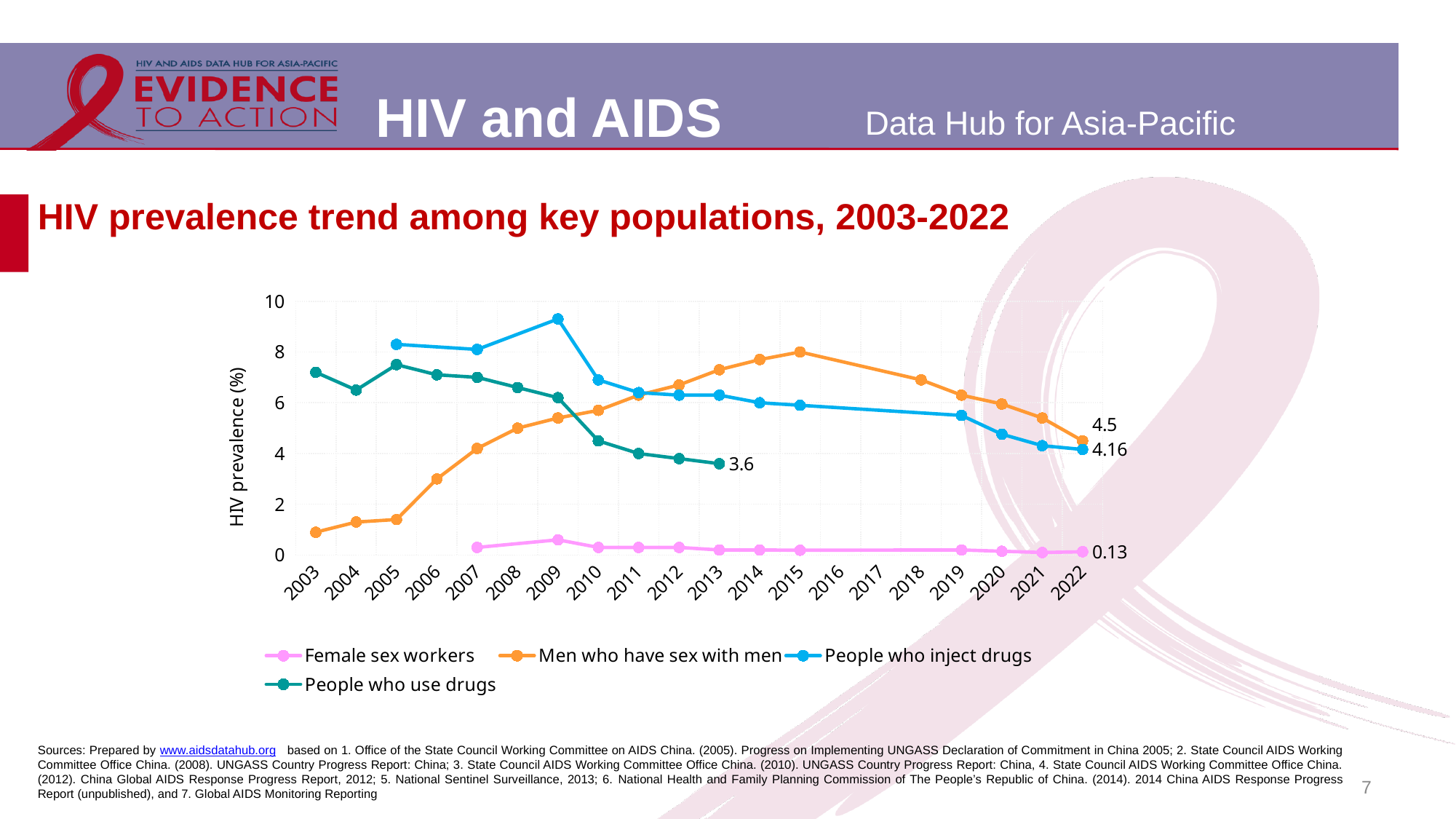
How many series does the legend list? 4 What is the HIV prevalence among men who have sex with men in 2022? 4.5 What is the HIV prevalence among people who inject drugs in 2022? 4.16 What is the difference between the 2022 values for men who have sex with men and people who inject drugs? 0.34 What is the last labelled value for people who use drugs, in 2013? 3.6 Is the value for men who have sex with men in 2003 greater or less than 2? less What kind of chart is shown on the slide? Line chart Is the value for people who inject drugs in 2009 greater or less than 8? greater In 2022, which is higher: the value for men who have sex with men or for people who inject drugs? Men who have sex with men Which series reaches the highest point on the chart? People who inject drugs Does the line for people who use drugs rise or fall from 2003 to 2013? Fall What is the HIV prevalence among female sex workers in 2022? 0.13